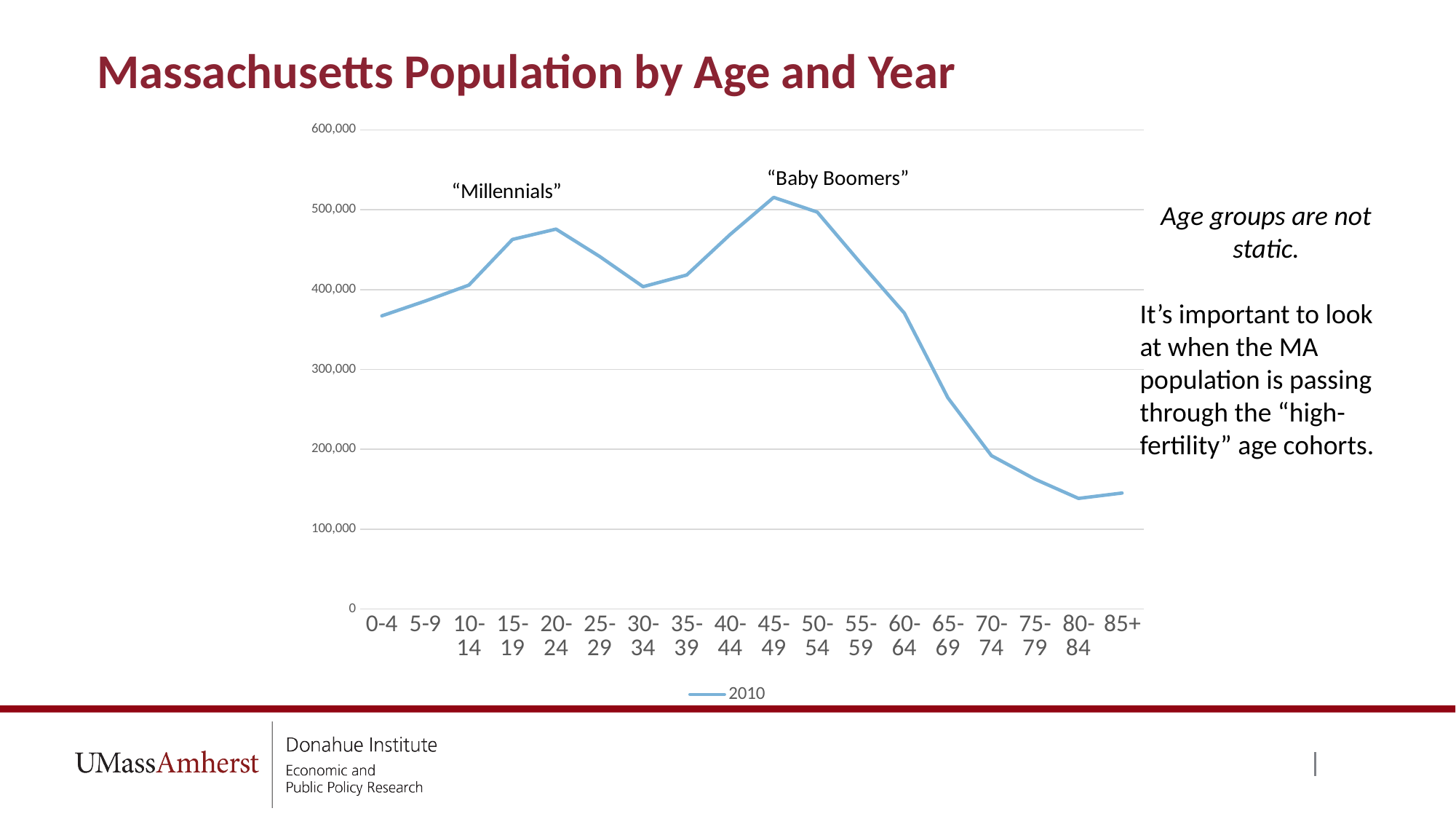
Which has the larger value, the 20-24 age group or the 30-34 age group? 20-24 How many age groups are plotted along the x axis? 18 Is the value for the 0-4 age group greater or less than 400,000? less Is the value for the 85+ age group greater or less than 200,000? less Which age group has the highest population value? 45-49 Is the value for the 45-49 age group greater or less than 500,000? greater Do the values rise or fall along the x axis from the 45-49 age group to the 80-84 age group? fall Which generation label is placed above the peak at the 45-49 age group? "Baby Boomers" What series name is shown in the chart legend? 2010 What kind of chart is shown on the slide? Line chart How many series does the legend list? 1